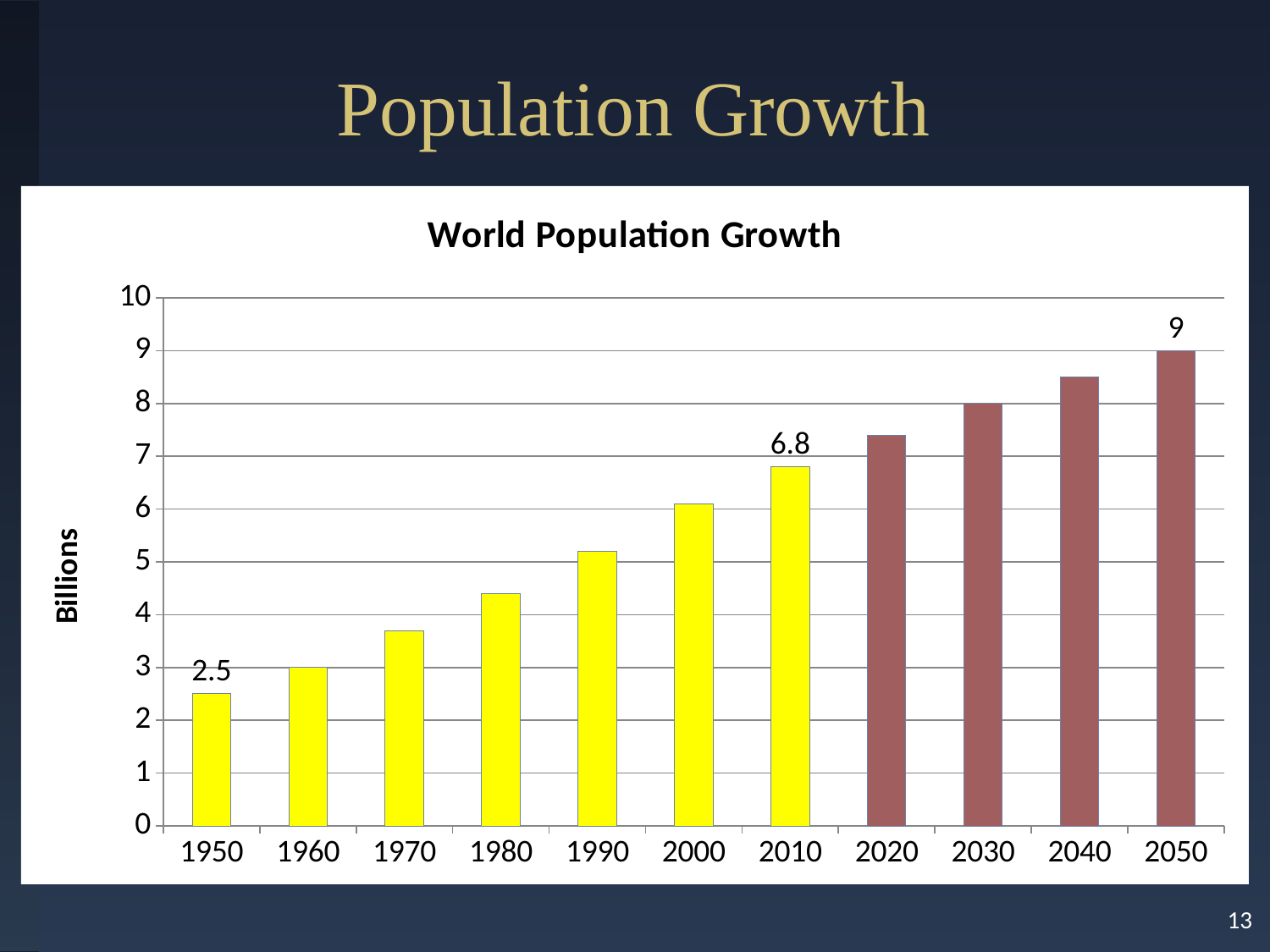
What is the value for 1950 in the World Population Growth chart? 2.5 Do the values in the World Population Growth chart rise or fall from 1950 to 2050? rise Which year has the lowest value in the World Population Growth chart? 1950 Is the value for 1980 in the World Population Growth chart greater or less than 5? less How many years are shown on the x axis of the World Population Growth chart? 11 Which year has the highest value in the World Population Growth chart? 2050 Which year has the larger value in the World Population Growth chart, 1990 or 2000? 2000 What is the value for 2050 in the World Population Growth chart? 9 Is the value for 2020 in the World Population Growth chart greater or less than 7? greater What is the value for 2010 in the World Population Growth chart? 6.8 What is the difference between the values for 2050 and 1950 in the World Population Growth chart? 6.5 What is the difference between the values for 2010 and 1950 in the World Population Growth chart? 4.3